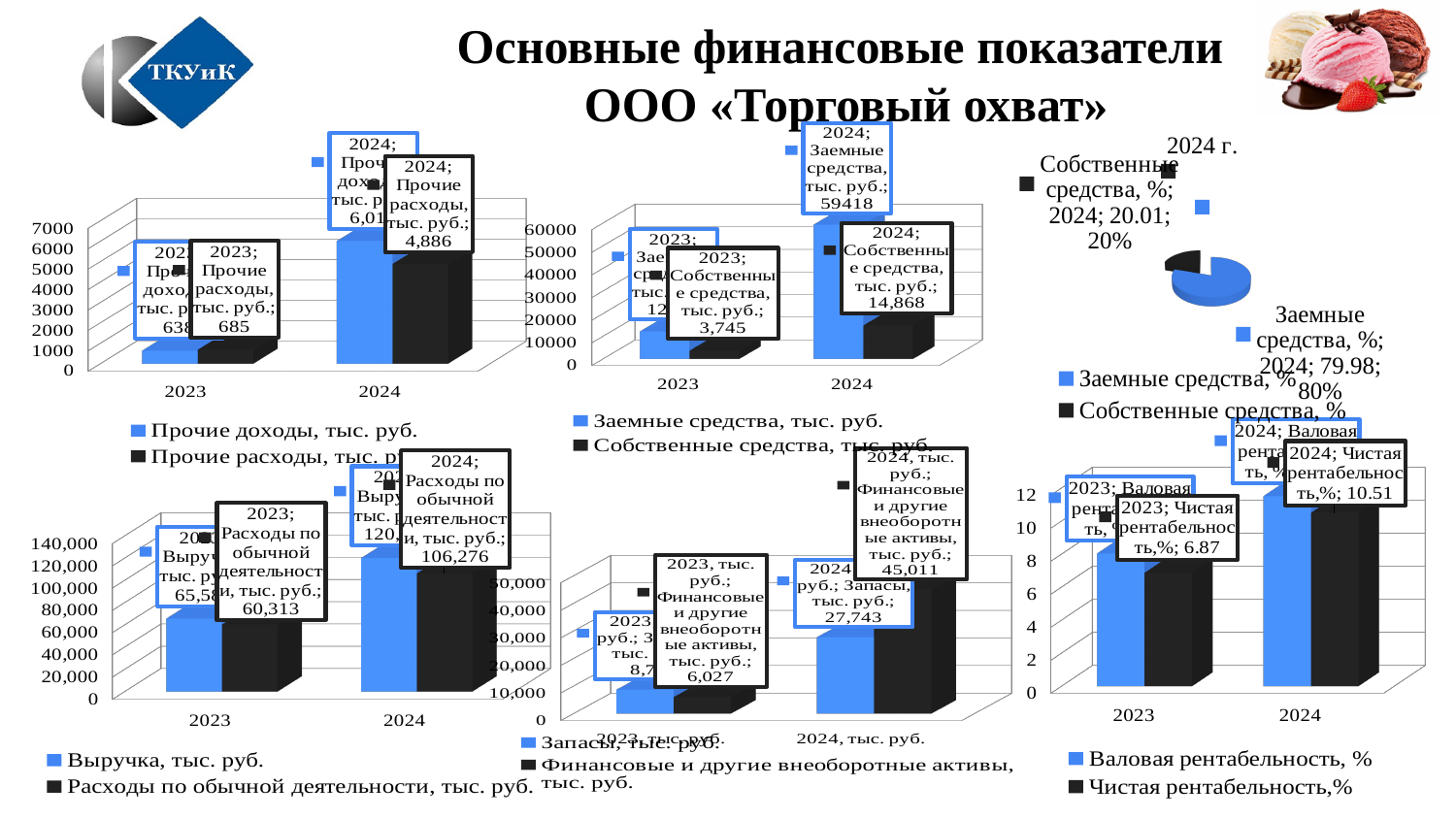
On the top-middle chart (Заемные средства / Собственные средства), what is the value of Собственные средства, тыс. руб. for 2024? 14,868 On the top-middle chart (Заемные средства / Собственные средства), what is the value of Заемные средства, тыс. руб. for 2024? 59418 On the bottom-left chart (Выручка / Расходы по обычной деятельности), what is the value of Расходы по обычной деятельности, тыс. руб. for 2024? 106,276 On the top-left chart (Прочие доходы / Прочие расходы), what is the value of Прочие расходы, тыс. руб. for 2024? 4,886 On the top-right pie chart (2024 г.), what is the value shown for Собственные средства, %? 20.01 On the bottom-middle chart (Запасы / Финансовые и другие внеоборотные активы), what is the value of Финансовые и другие внеоборотные активы for 2024? 45,011 On the top-left chart (Прочие доходы / Прочие расходы), what is the difference between Прочие расходы in 2024 and in 2023? 4,201 On the bottom-left chart (Выручка / Расходы по обычной деятельности), what is the value of Расходы по обычной деятельности, тыс. руб. for 2023? 60,313 On the top-right pie chart (2024 г.), what share does Заемные средства, % have? 80% On the top-left chart (Прочие доходы / Прочие расходы), what is the value of Прочие расходы, тыс. руб. for 2023? 685 On the top-middle chart (Заемные средства / Собственные средства), what is the value of Собственные средства, тыс. руб. for 2023? 3,745 On the bottom-right chart (Валовая рентабельность / Чистая рентабельность), what is the value of Чистая рентабельность,% for 2024? 10.51